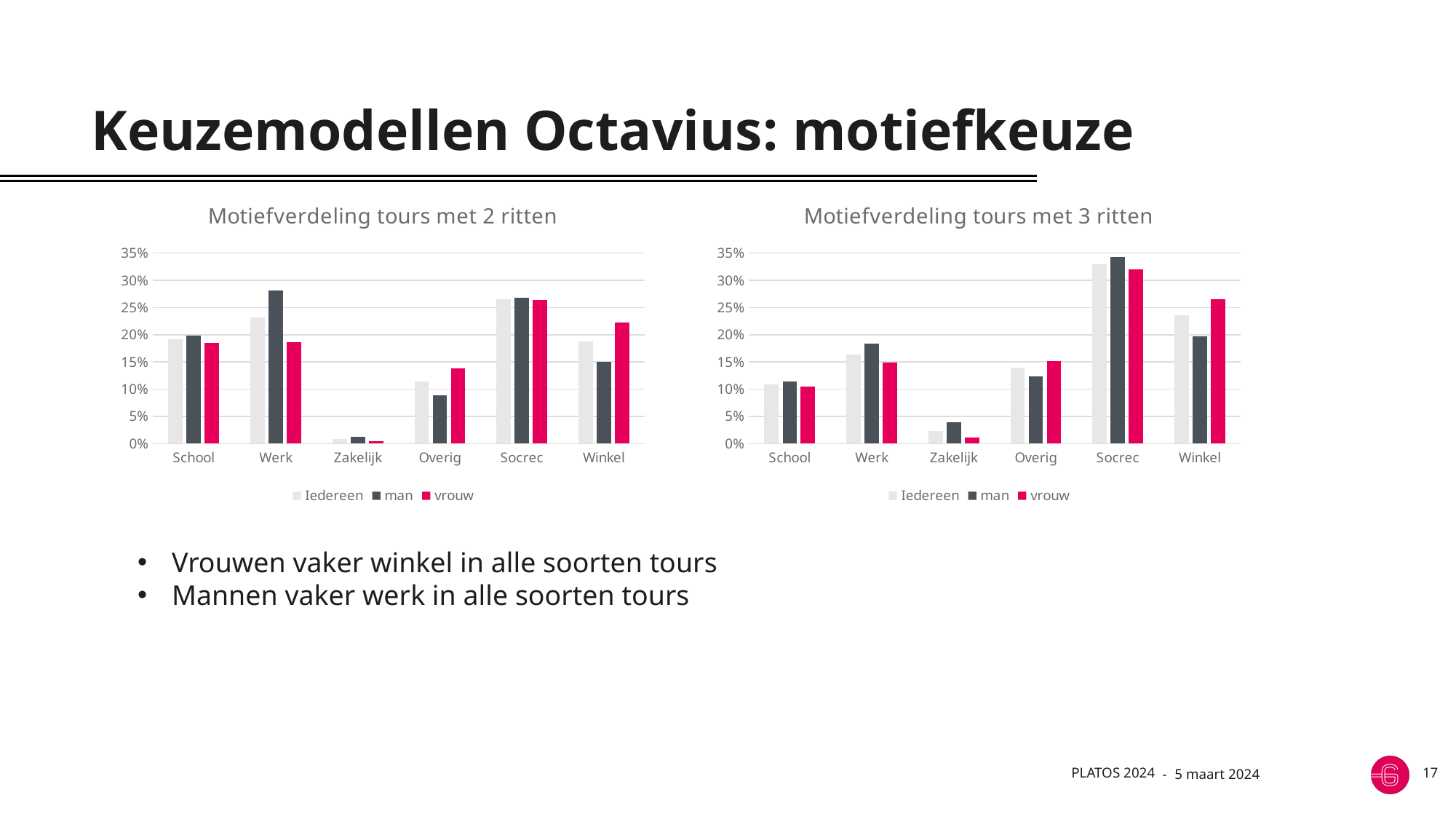
In the right chart 'Motiefverdeling tours met 3 ritten', is the value for 'vrouw' at Socrec greater or less than 30%? greater In the left chart 'Motiefverdeling tours met 2 ritten', which is larger at Winkel: 'man' or 'vrouw'? vrouw What is the title of the right chart on the slide? Motiefverdeling tours met 3 ritten In the right chart 'Motiefverdeling tours met 3 ritten', how many series does the legend list? 3 In the left chart 'Motiefverdeling tours met 2 ritten', which category has the highest value for the 'vrouw' series? Socrec In the left chart 'Motiefverdeling tours met 2 ritten', is the value for 'man' at Overig greater or less than 10%? less In the left chart 'Motiefverdeling tours met 2 ritten', is the value for 'man' at Werk greater or less than 25%? greater In the right chart 'Motiefverdeling tours met 3 ritten', which is larger at Werk: 'man' or 'vrouw'? man What kind of chart is the left chart, 'Motiefverdeling tours met 2 ritten'? bar chart In the right chart 'Motiefverdeling tours met 3 ritten', which category has the highest value for the 'Iedereen' series? Socrec In the left chart 'Motiefverdeling tours met 2 ritten', which category has the lowest value for the 'man' series? Zakelijk In the left chart 'Motiefverdeling tours met 2 ritten', how many categories are shown on the x axis? 6